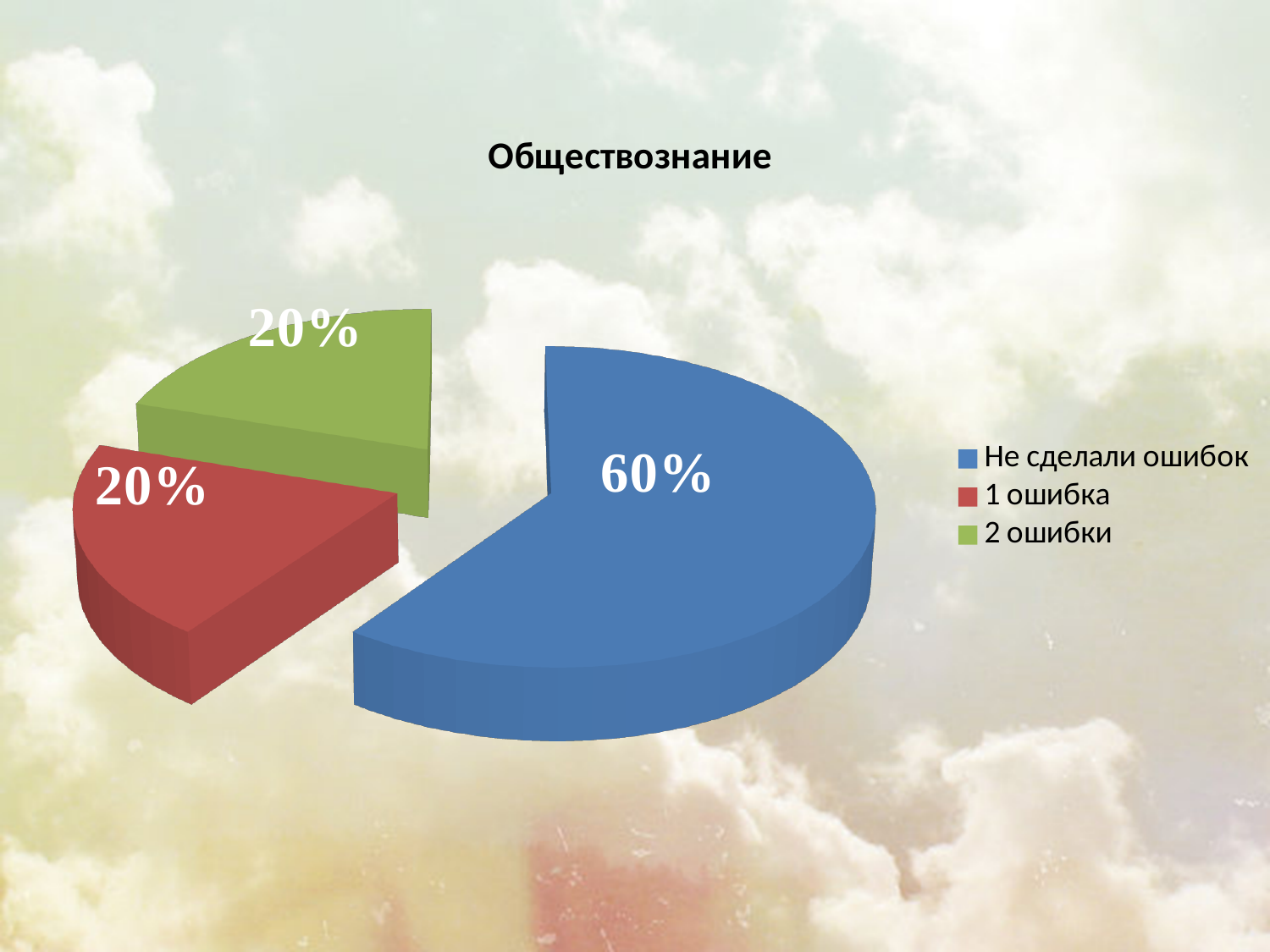
What kind of chart is shown on the slide? pie chart What is the combined share of "1 ошибка" and "2 ошибки"? 40% Which category has the largest slice of the pie? Не сделали ошибок What share of the pie is labelled "1 ошибка"? 20% What share of the pie is labelled "Не сделали ошибок"? 60% How many slices does the pie chart have? 3 What is the difference between the share for "Не сделали ошибок" and the share for "1 ошибка"? 40% What colour is the slice for "1 ошибка"? red Which is larger, the share for "Не сделали ошибок" or the share for "2 ошибки"? Не сделали ошибок How many entries does the legend list? 3 What is the title of the chart? Обществознание What share of the pie is labelled "2 ошибки"? 20%